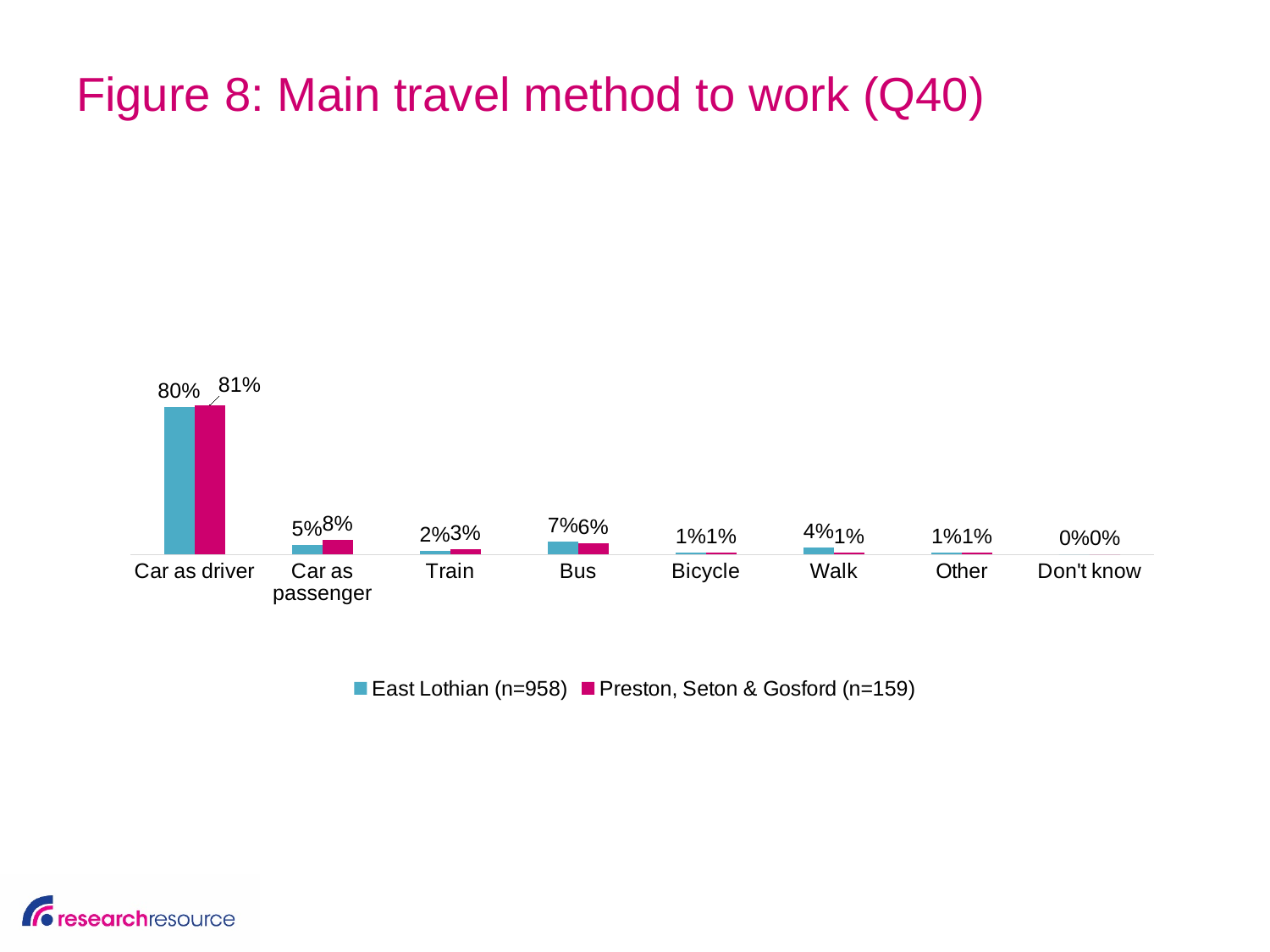
What is the value for Walk for East Lothian (n=958)? 4% How many series does the legend list? 2 What is the difference between the Car as passenger values for Preston, Seton & Gosford (n=159) and East Lothian (n=958)? 3% What kind of chart is shown on the slide? Bar chart For Walk, which series has the larger value: East Lothian (n=958) or Preston, Seton & Gosford (n=159)? East Lothian (n=958) What is the value for Bus for Preston, Seton & Gosford (n=159)? 6% What is the value for Car as driver for East Lothian (n=958)? 80% What is the title of the chart? Figure 8: Main travel method to work (Q40) What is the value for Car as passenger for Preston, Seton & Gosford (n=159)? 8% Which category has the highest value for East Lothian (n=958)? Car as driver Which category has the lowest value for Preston, Seton & Gosford (n=159)? Don't know How many categories are shown on the x axis? 8